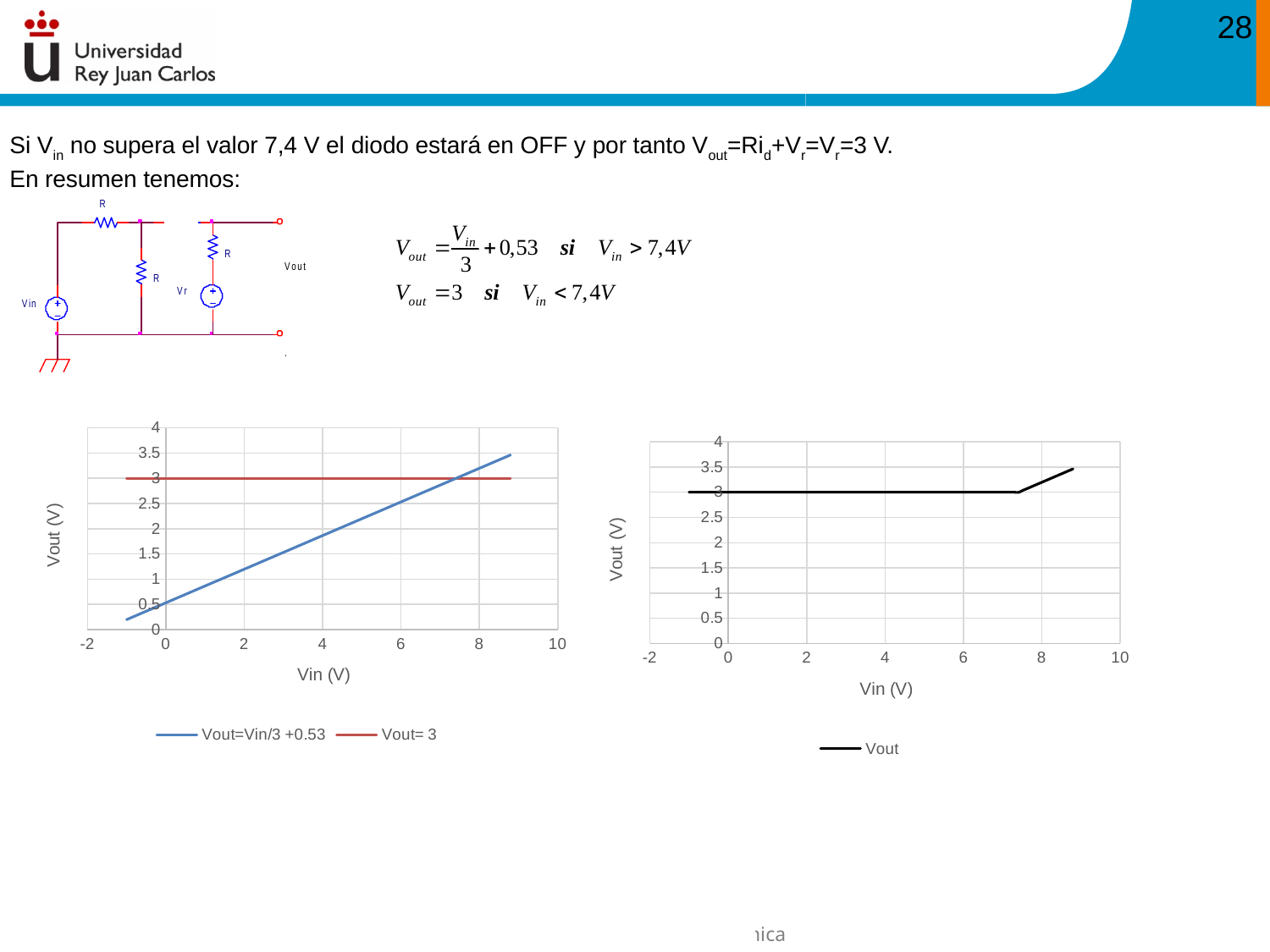
How many series does the legend of the right chart list? 1 How many series does the legend of the left chart list? 2 In the left chart, at what constant value does the red line (Vout= 3) stay? 3 In the left chart, what are the two legend entries? Vout=Vin/3 +0.53 and Vout= 3 In the right chart, what is the title of the x axis? Vin (V) In the right chart, does the Vout line rise or stay flat between Vin = 0 and Vin = 6? stays flat In the left chart, at Vin = 0, which series has the higher value: Vout=Vin/3 +0.53 or Vout= 3? Vout= 3 In the right chart, is the value of Vout at Vin = 4 greater or less than 2? greater In the left chart, is the value of Vout=Vin/3 +0.53 at Vin = 2 greater or less than 1? greater In the left chart, does the blue line (Vout=Vin/3 +0.53) rise or fall as Vin increases? rises In the left chart, is the value of Vout=Vin/3 +0.53 at Vin = 6 greater or less than 2? greater What kind of chart is the left chart? line chart